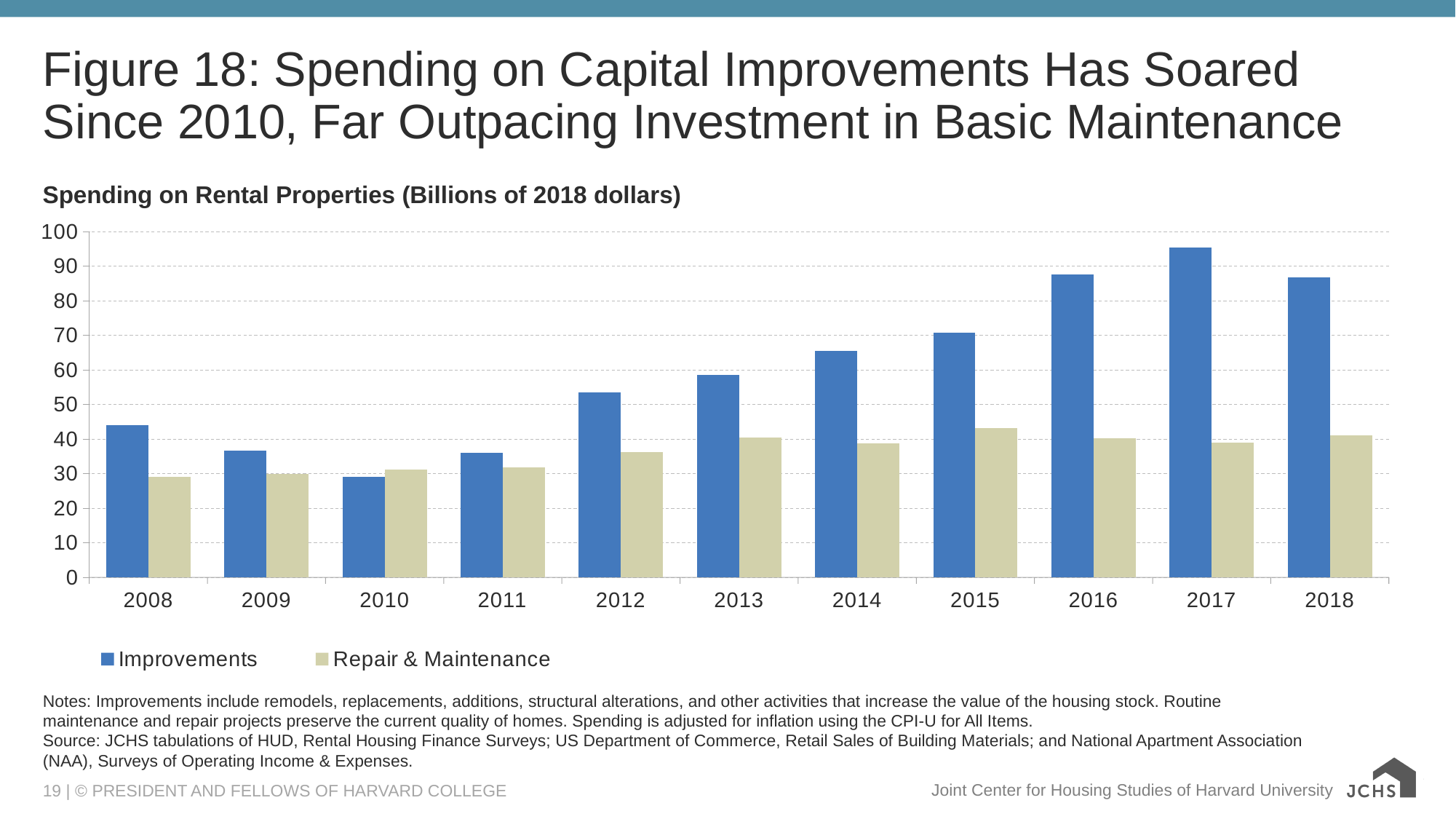
What type of chart is shown on the slide? Bar chart Is the Improvements value for 2017 greater or less than 90? greater Is the Improvements value for 2012 greater or less than 50? greater How many series does the legend list? 2 Does Improvements spending rise or fall from 2010 to 2017? Rise What is the chart's subtitle describing the units of the data? Spending on Rental Properties (Billions of 2018 dollars) Is the Repair & Maintenance value for 2015 greater or less than 40? greater In which year is Improvements spending lowest? 2010 In which year is Improvements spending highest? 2017 How many years are shown on the x axis? 11 In 2008, which is larger: Improvements or Repair & Maintenance? Improvements